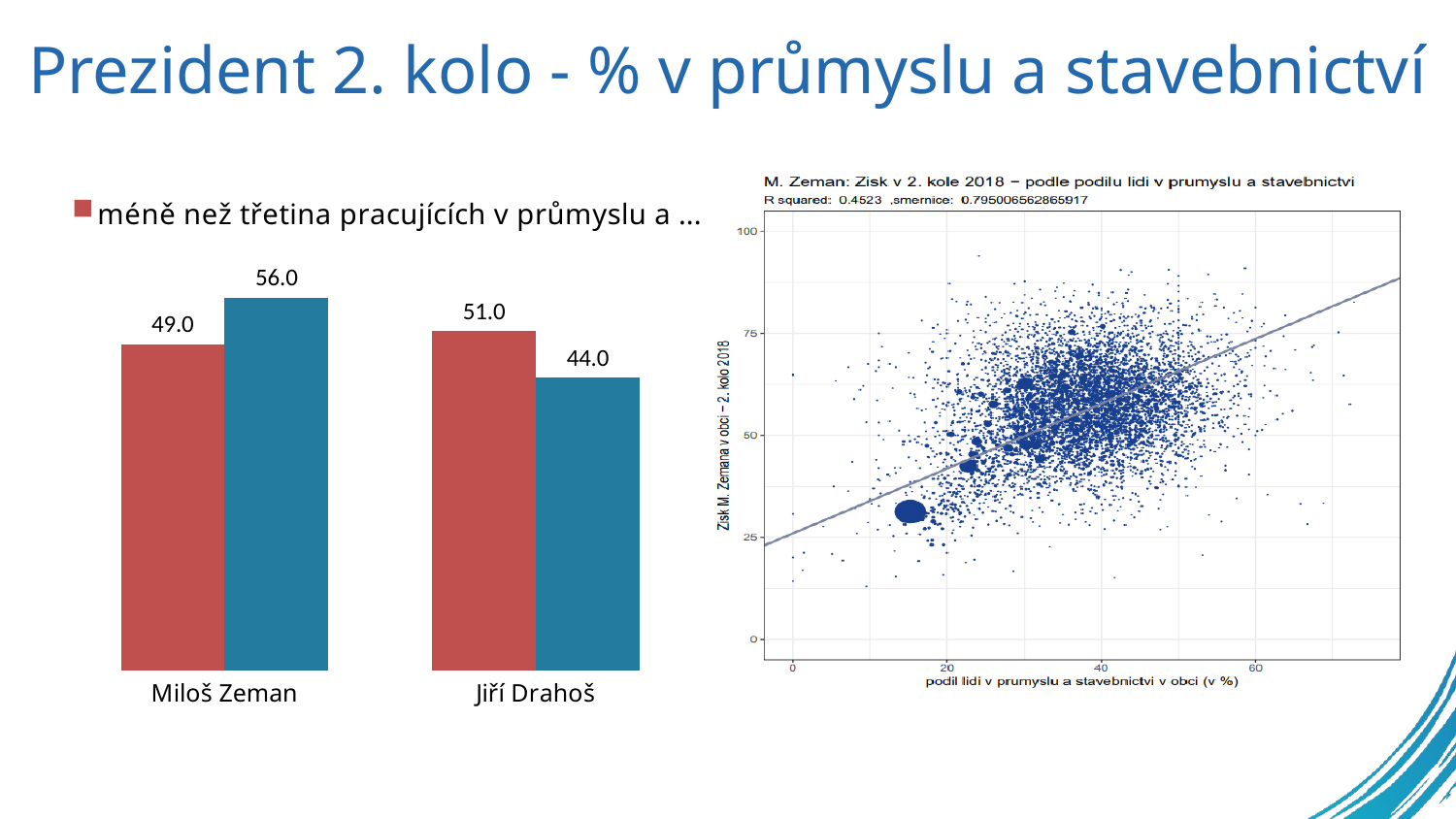
How many candidates are shown in the bar chart on the left? 2 In the bar chart on the left, which candidate has the larger red bar, Miloš Zeman or Jiří Drahoš? Jiří Drahoš In the bar chart on the left, what is the difference between the blue and red bars for Miloš Zeman? 7.0 In the scatter plot on the right, does the fitted line rise or fall as the share of people in industry and construction increases? Rises In the bar chart on the left, which bar has the lowest value? The blue bar for Jiří Drahoš (44.0) In the bar chart on the left, what is the value of the blue bar for Miloš Zeman? 56.0 In the bar chart on the left, what is the value of the red bar for Miloš Zeman? 49.0 In the bar chart on the left, what is the value of the red bar for Jiří Drahoš? 51.0 What R squared value is printed above the scatter plot on the right? 0.4523 In the bar chart on the left, what is the value of the blue bar for Jiří Drahoš? 44.0 What kind of chart is shown on the right side of the slide? Scatter plot In the bar chart on the left, which bar has the highest value? The blue bar for Miloš Zeman (56.0)